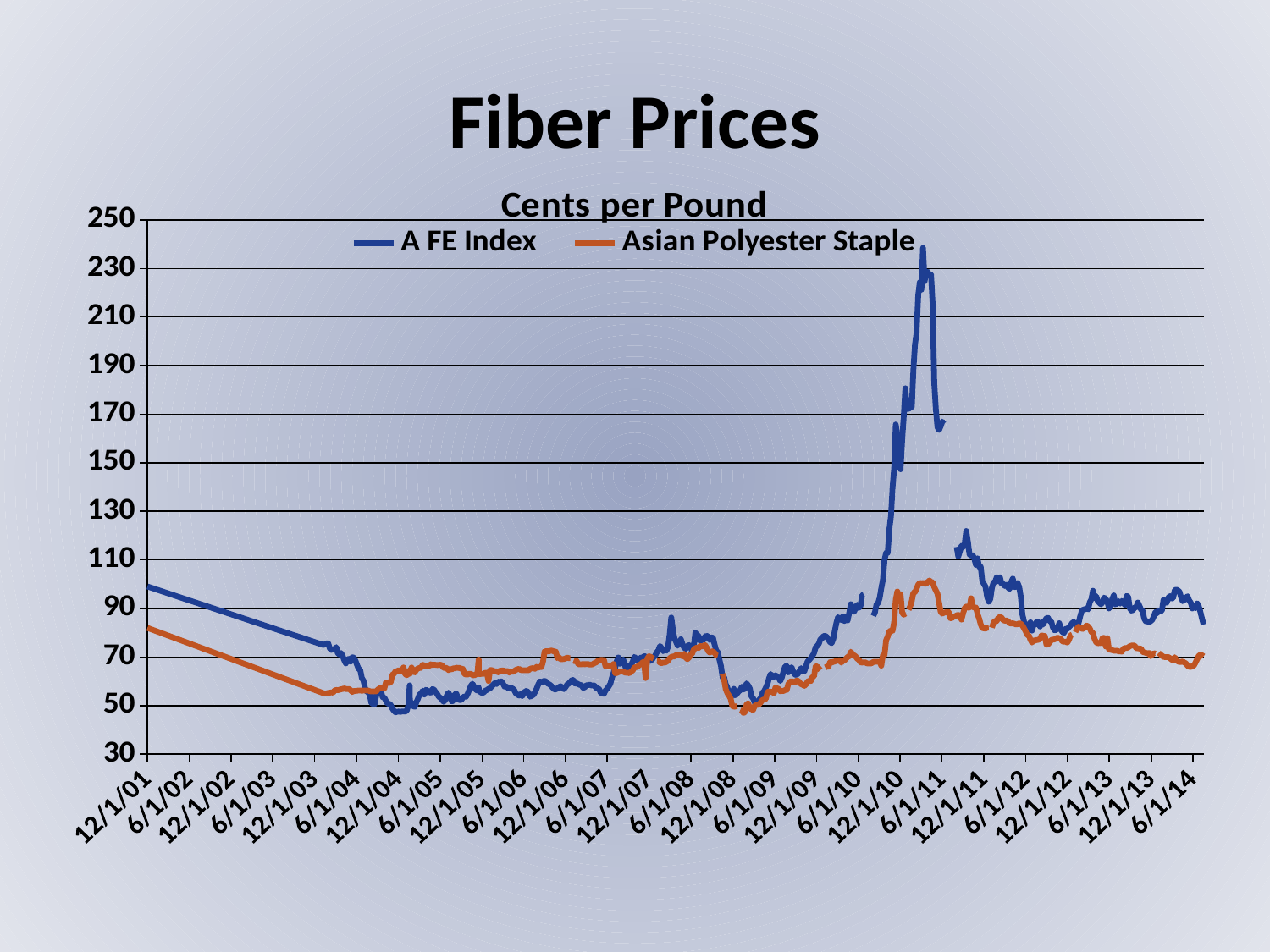
Which series reaches the higher peak in 2011, A FE Index or Asian Polyester Staple? A FE Index Does the A FE Index rise or fall between 12/1/01 and 12/1/03? fall What kind of chart is shown on the slide? line chart How many series does the chart legend list? 2 Is the peak value of Asian Polyester Staple around 2011 greater or less than 110? less Is the value of Asian Polyester Staple at 12/1/01 greater or less than 70? greater Is the peak value of the A FE Index in 2011 greater or less than 210? greater What is the title shown above the chart's plot area? Cents per Pound At 12/1/01, which series has the higher value, A FE Index or Asian Polyester Staple? A FE Index Which series is drawn in orange? Asian Polyester Staple